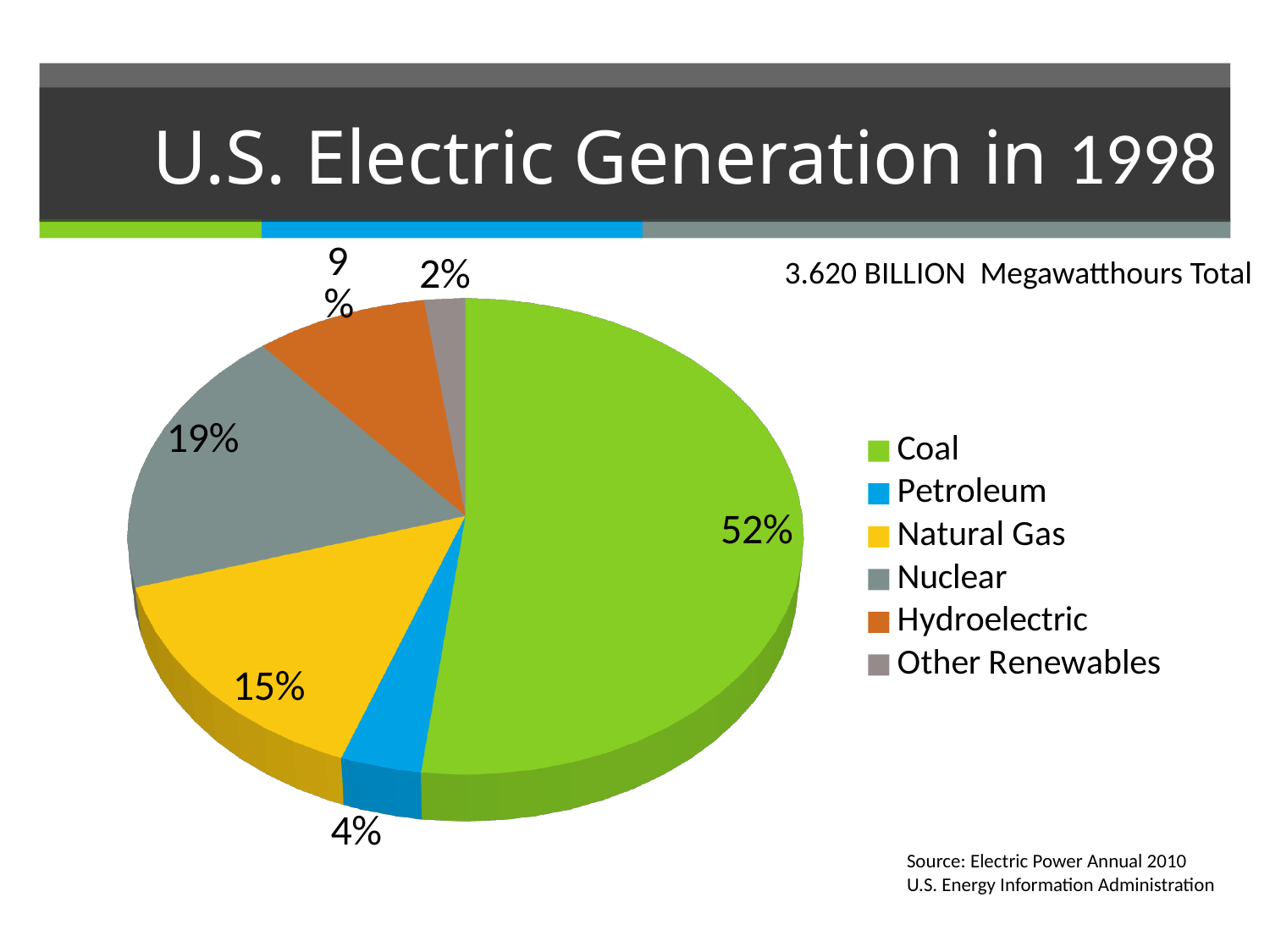
What share of U.S. electric generation in 1998 came from Nuclear? 19% Which source has the smallest share of the pie? Other Renewables What share of U.S. electric generation in 1998 came from Petroleum? 4% What total generation is stated on the slide? 3.620 BILLION Megawatthours What share of U.S. electric generation in 1998 came from Other Renewables? 2% Which has a larger share, Natural Gas or Hydroelectric? Natural Gas What kind of chart is shown on the slide? Pie chart What share of U.S. electric generation in 1998 came from Coal? 52% How many categories does the legend list? 6 Which source has the largest share of the pie? Coal What is the difference in percentage points between the Coal share and the Nuclear share? 33 What share of U.S. electric generation in 1998 came from Natural Gas? 15%